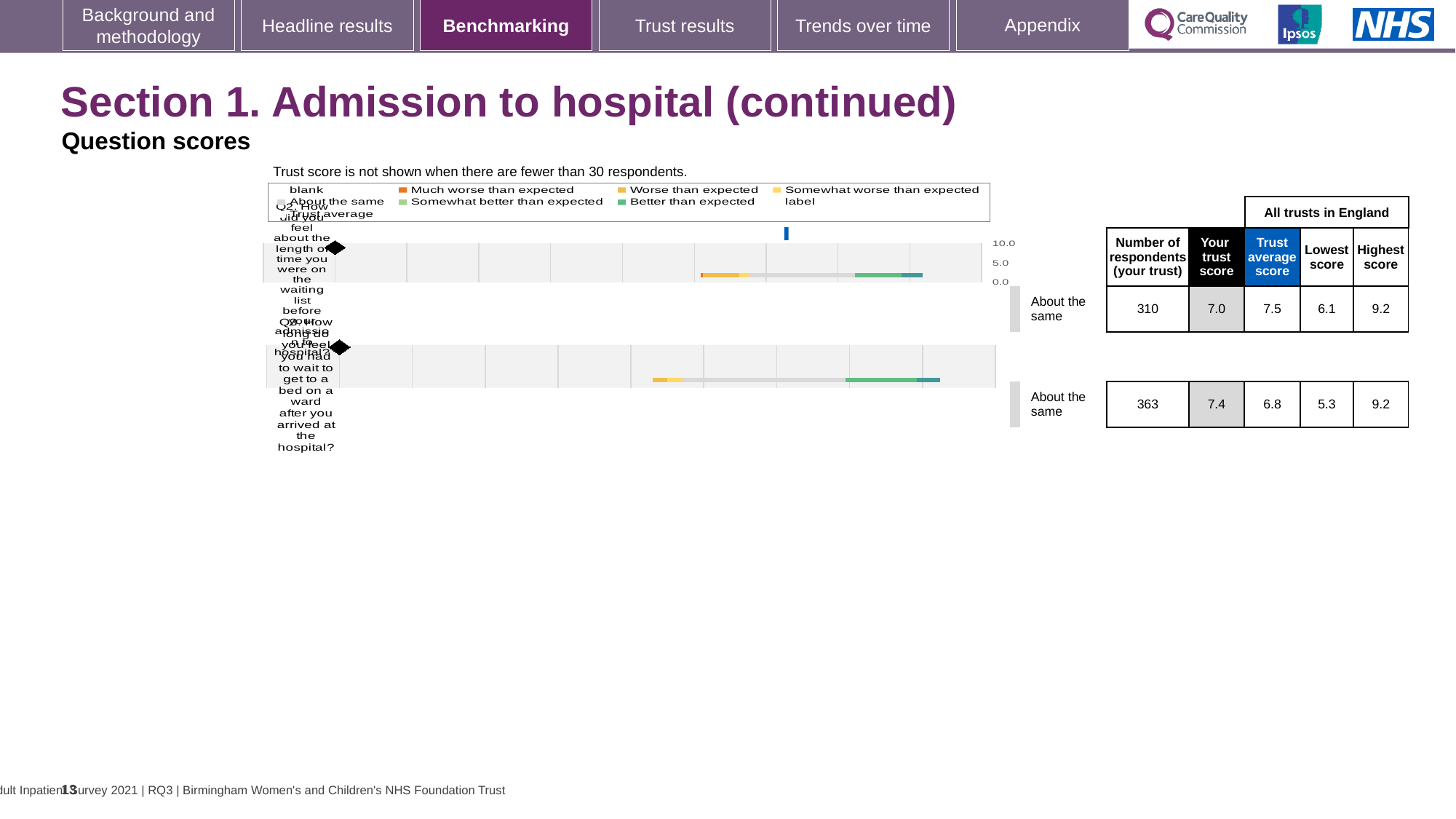
What is the 'Your trust score' value for Q3 (wait to get to a bed on a ward after arriving at the hospital)? 7.4 For Q2, which is larger: your trust score or the trust average score? Trust average score (7.5) What is the trust average score for Q3? 6.8 How is your trust's result for Q2 categorised relative to expectations? About the same According to the note above the chart, when is a trust score not shown? When there are fewer than 30 respondents What is the 'Your trust score' value for Q2 (length of time on the waiting list before admission)? 7.0 How many questions (rows) are plotted in the question scores chart? 2 What is the lowest score across all trusts in England for Q2? 6.1 What kind of chart is used to show the question scores on this slide? bar chart For Q3, what is the difference between the highest score and the lowest score across all trusts in England? 3.9 How many respondents from your trust answered Q2? 310